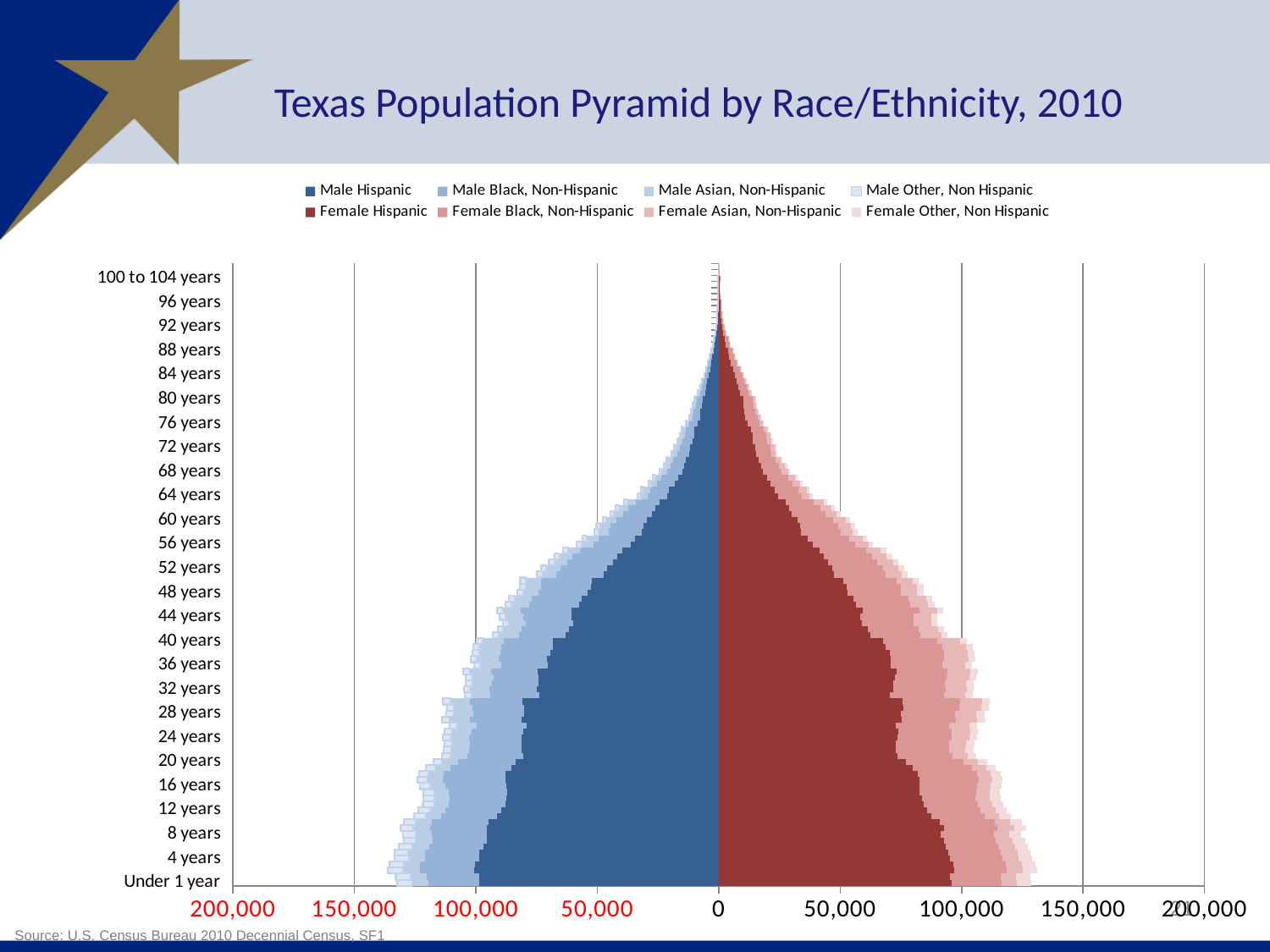
Is the total value for the 100 to 104 years age group on the female side greater or less than 50,000? less At 80 years, which side has the larger total bar, male or female? female Is the total female value for the Under 1 year age group greater or less than 100,000? greater Is the total male value for the Under 1 year age group greater or less than 100,000? greater How many series does the legend list? 8 Which legend entry is shown in the darkest blue colour? Male Hispanic What kind of chart is shown on the slide? bar chart Moving from the youngest age group at the bottom to the oldest at the top, do the bar lengths generally increase or decrease? decrease What is the title of the chart? Texas Population Pyramid by Race/Ethnicity, 2010